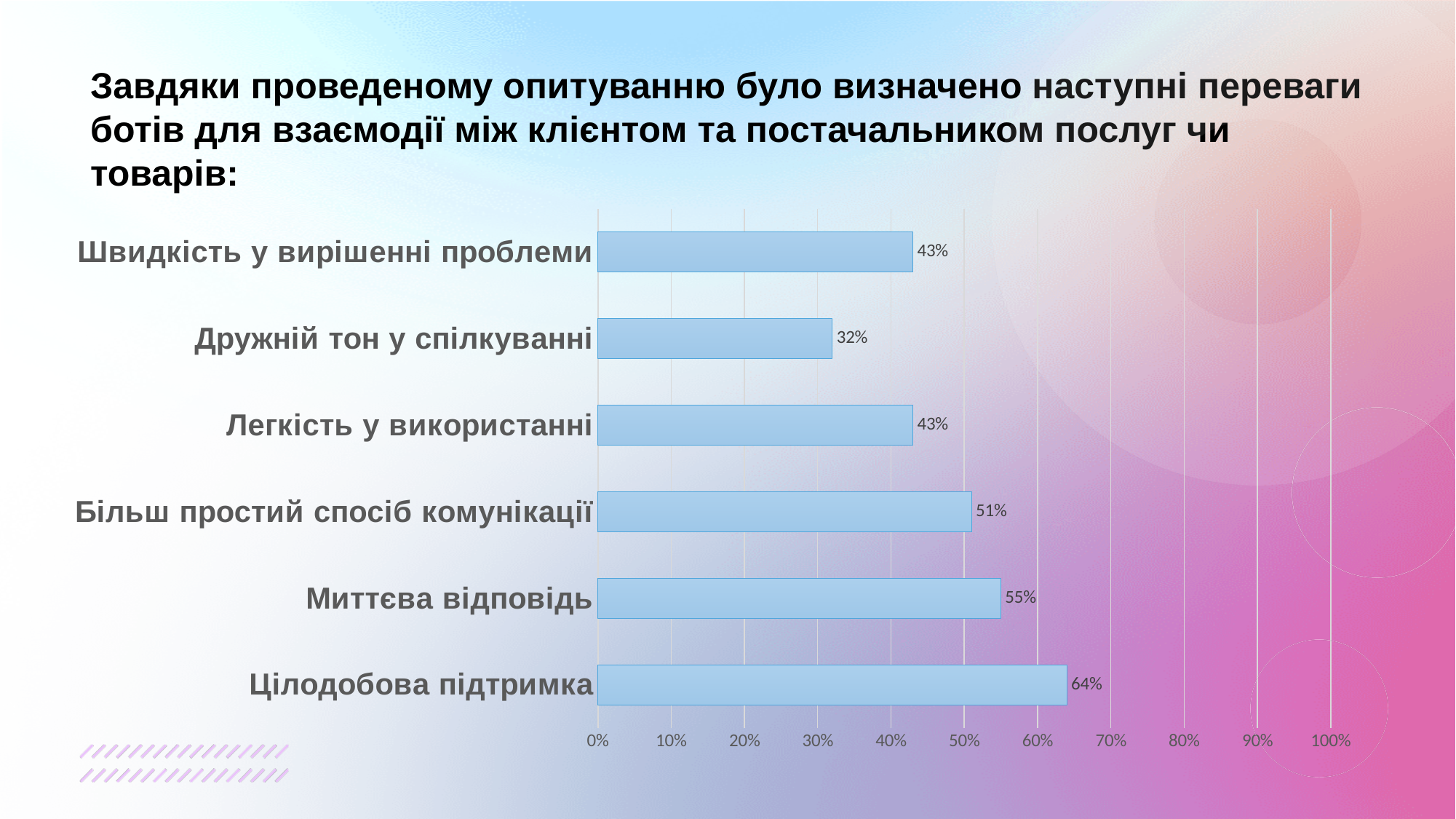
What is the value for Більш простий спосіб комунікації? 51% Is the value for Миттєва відповідь greater or less than 50%? greater What is the value for Миттєва відповідь? 55% Which category has the lowest value? Дружній тон у спілкуванні What is the value for Цілодобова підтримка? 64% How many categories are shown in the chart? 6 What is the difference between the values for Цілодобова підтримка and Миттєва відповідь? 9% Which category has the highest value? Цілодобова підтримка What is the value for Дружній тон у спілкуванні? 32% What kind of chart is shown on the slide? bar chart What is the difference between the values for Швидкість у вирішенні проблеми and Дружній тон у спілкуванні? 11% Which is larger, the value for Більш простий спосіб комунікації or the value for Легкість у використанні? Більш простий спосіб комунікації